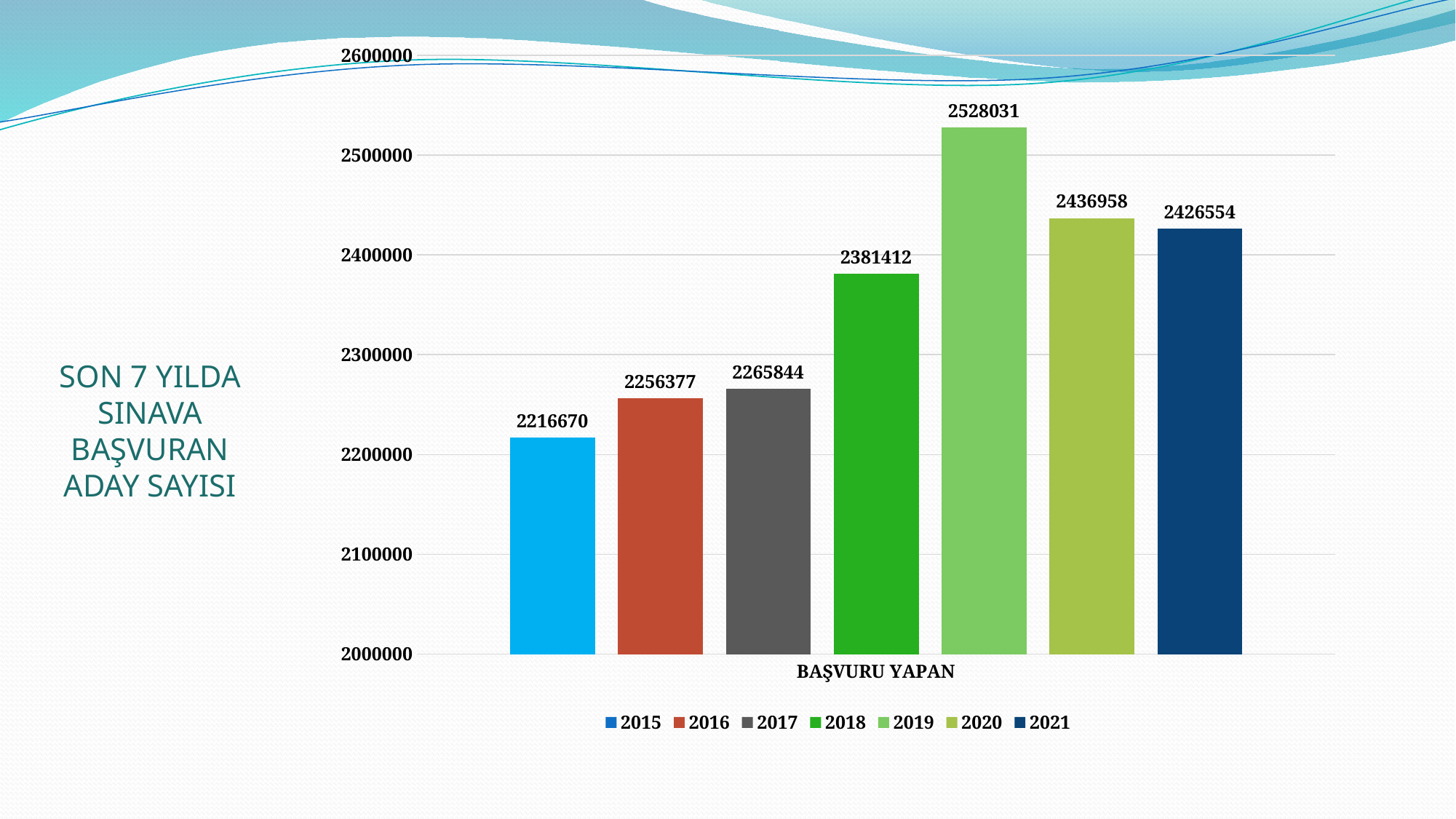
What is the difference between the values for 2020 and 2021? 10404 What is the value for 2015 in the chart? 2216670 Which year has the lowest value in the chart? 2015 What is the value for 2019 in the chart? 2528031 Is the value for 2020 greater or less than 2400000? greater How many series does the legend list? 7 Which year has the highest value in the chart? 2019 Which is larger, the value for 2018 or the value for 2017? 2018 What is the difference between the values for 2019 and 2015? 311361 What is the value for 2021 in the chart? 2426554 Do the values rise or fall from 2015 to 2019? rise What kind of chart is shown on the slide? bar chart